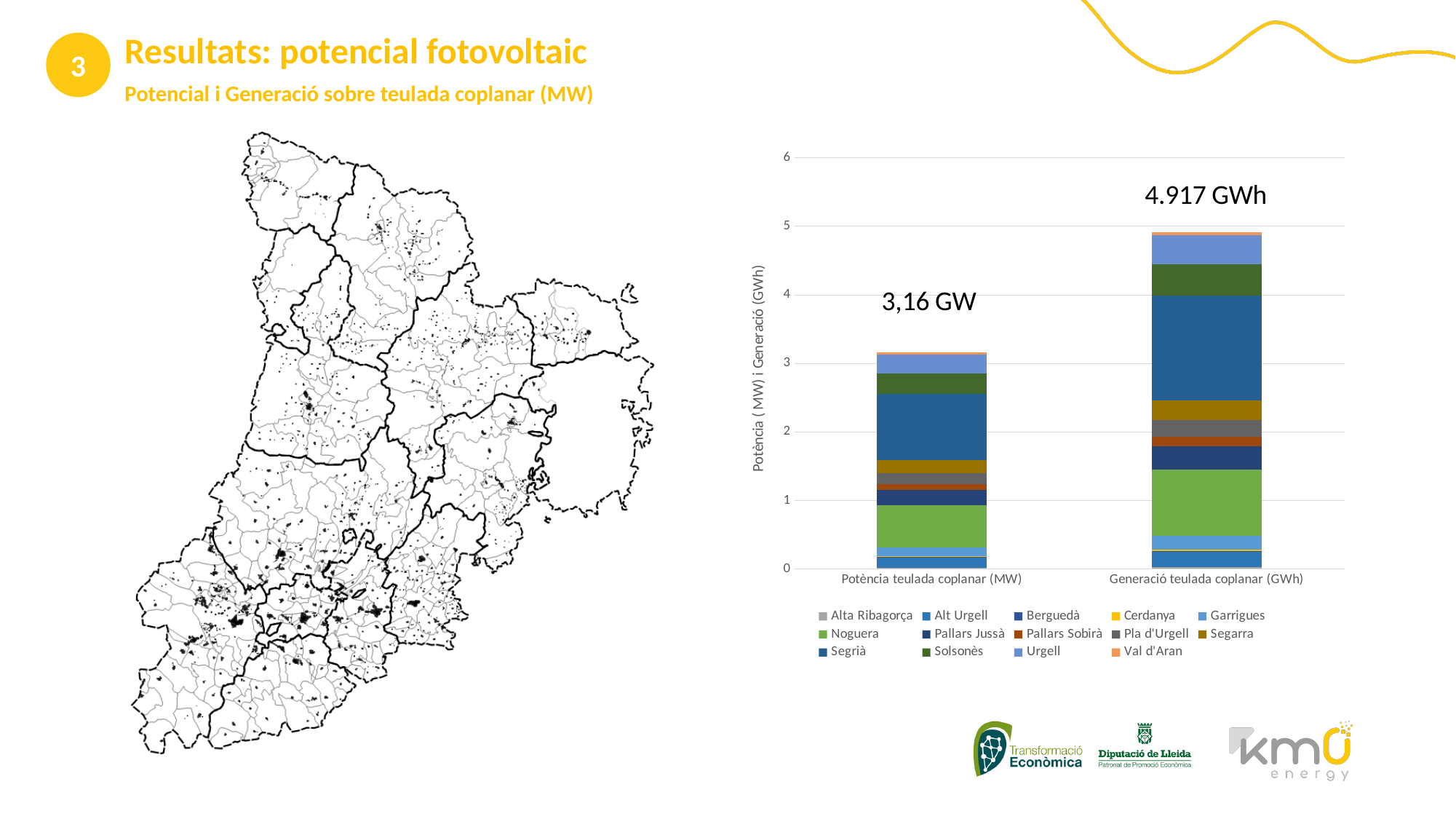
What is the first entry listed in the chart's legend? Alta Ribagorça How many series does the chart's legend list? 14 Which of the two bars is taller, 'Potència teulada coplanar (MW)' or 'Generació teulada coplanar (GWh)'? Generació teulada coplanar (GWh) Is the top of the 'Potència teulada coplanar (MW)' bar greater or less than 2 on the y axis? greater What total value is labelled above the 'Generació teulada coplanar (GWh)' bar? 4.917 GWh What is the title of the chart's y axis? Potència ( MW) i Generació (GWh) How many bars (categories) are plotted on the x axis of the chart? 2 What total value is labelled above the 'Potència teulada coplanar (MW)' bar? 3,16 GW Which series forms the largest segment in the 'Generació teulada coplanar (GWh)' bar? Segrià Is the top of the 'Potència teulada coplanar (MW)' bar greater or less than 4 on the y axis? less What kind of chart is shown on the slide? bar chart Is the top of the 'Generació teulada coplanar (GWh)' bar greater or less than 4 on the y axis? greater